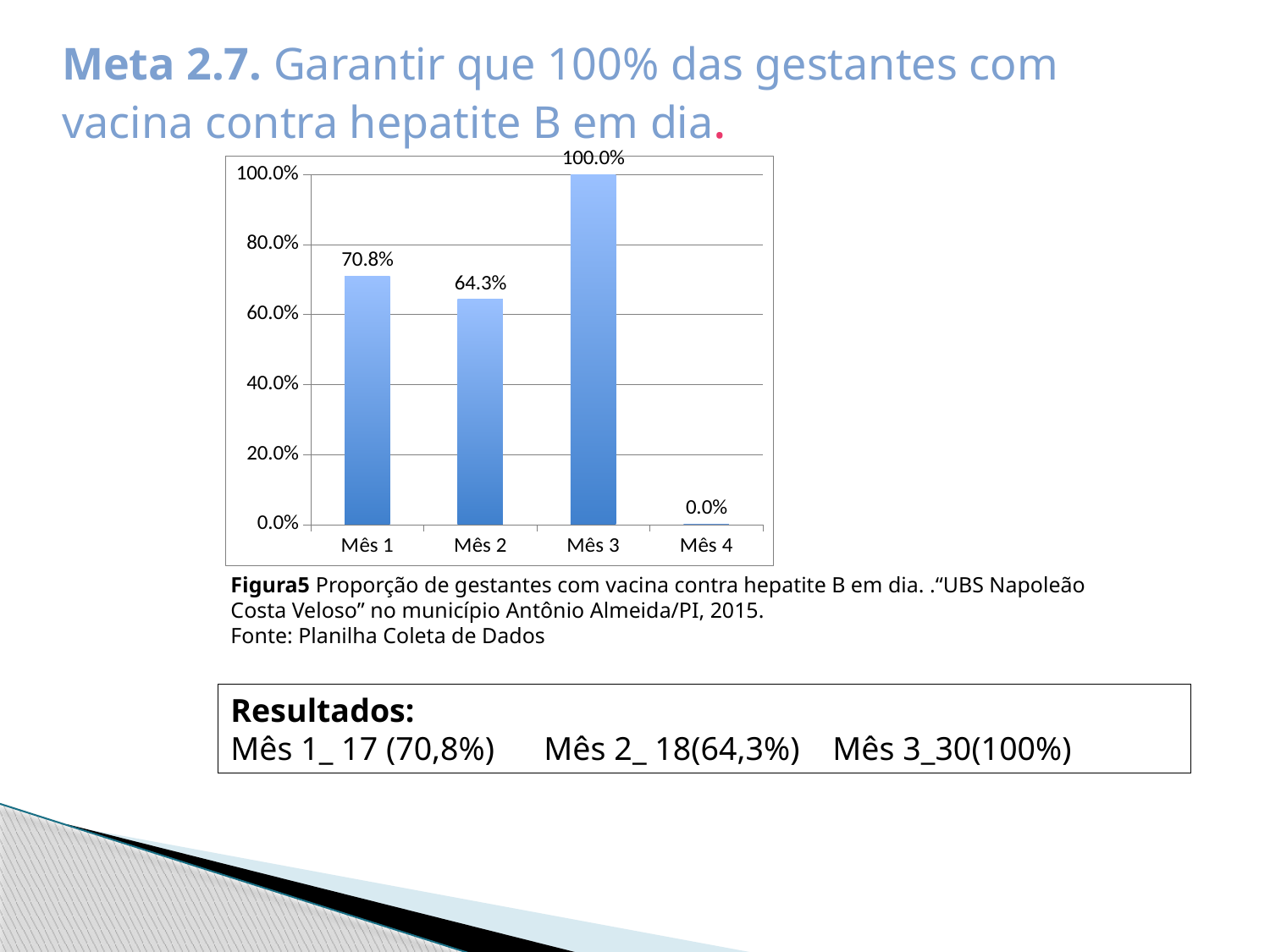
What is the value for Mês 4? 0.0% What is the value for Mês 1? 70.8% What is the value for Mês 2? 64.3% What kind of chart is shown on the slide? Bar chart What is the difference between the values for Mês 1 and Mês 2? 6.5% What is the value for Mês 3? 100.0% Which is larger, the value for Mês 1 or the value for Mês 2? Mês 1 Does the value rise or fall from Mês 2 to Mês 3? Rise How many months are shown on the x axis? 4 What is the difference between the values for Mês 3 and Mês 2? 35.7% Which month has the highest value? Mês 3 Which month has the lowest value? Mês 4